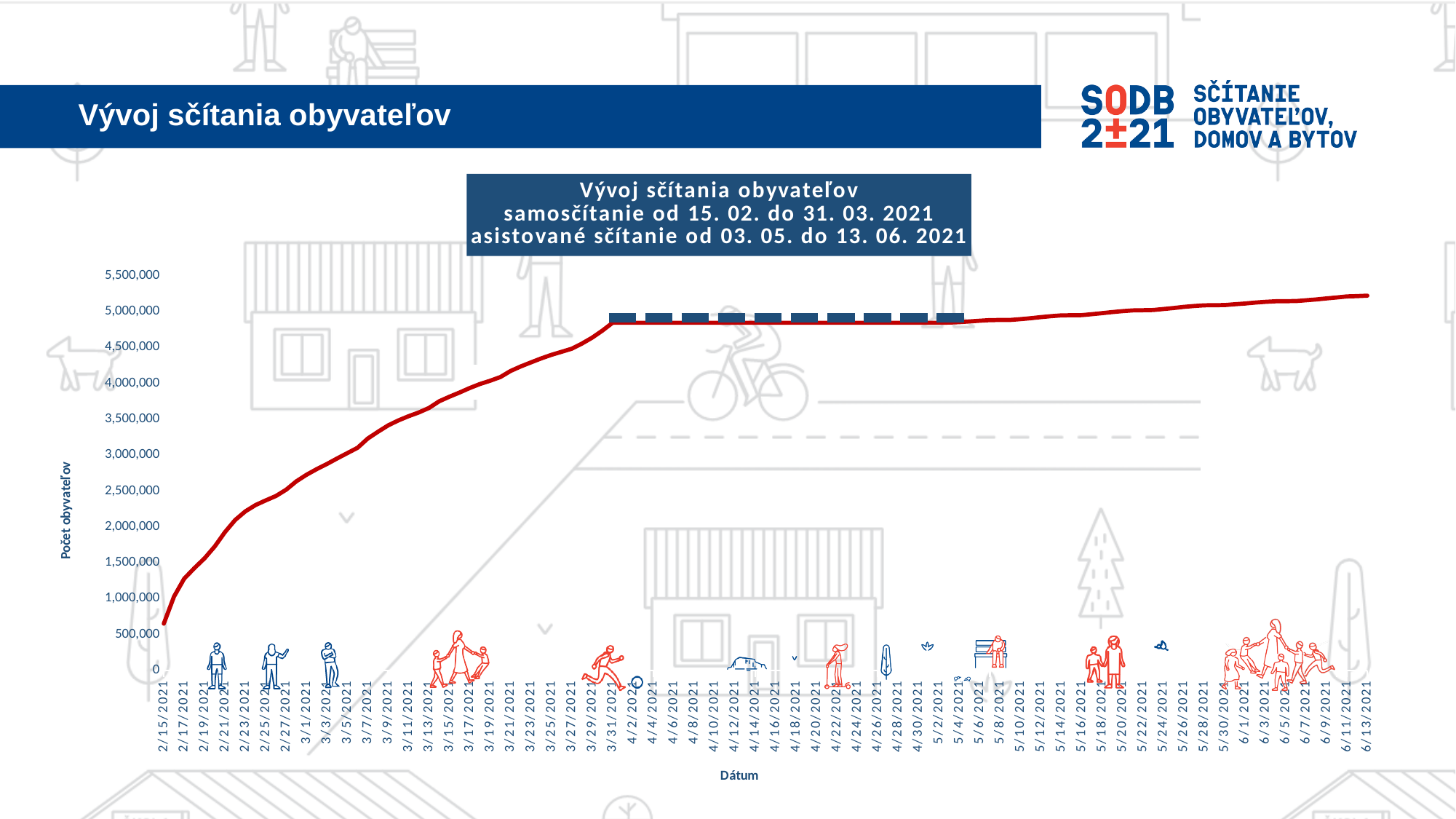
On which date does the line have its lowest value? 2/15/2021 Is the value for 3/31/2021 greater or less than 4,500,000? greater Is the value for 2/15/2021 greater or less than 1,000,000? less Is the value for 6/13/2021 greater or less than 5,000,000? greater Do the values rise or fall along the x axis from 2/15/2021 to 6/13/2021? rise What is the title of the x axis? Dátum On which date does the line reach its highest value? 6/13/2021 What kind of chart is shown on the slide? line chart Which date has the larger value, 2/15/2021 or 6/13/2021? 6/13/2021 What is the title of the y axis? Počet obyvateľov